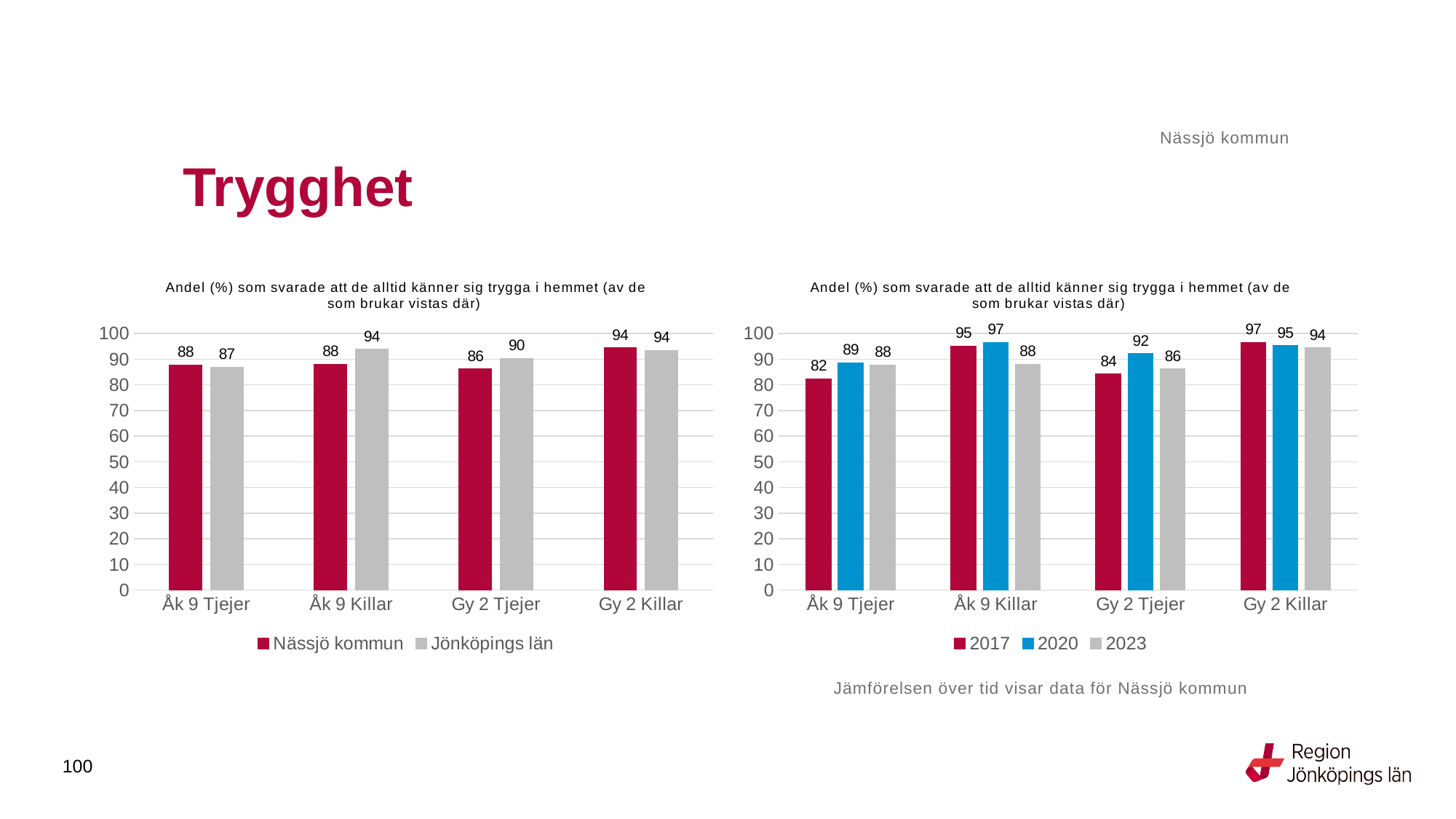
In the right chart, which category has the highest value for 2017? Gy 2 Killar In the right chart, what is the difference between the 2020 and 2017 values for Åk 9 Tjejer? 7 In the left chart, what is the value for Jönköpings län for Gy 2 Tjejer? 90 In the right chart, which is larger for Åk 9 Killar: the 2020 value or the 2023 value? 2020 In the left chart, which category has the lowest value for Nässjö kommun? Gy 2 Tjejer In the left chart, how many series does the legend list? 2 In the left chart, what is the difference between Jönköpings län and Nässjö kommun for Åk 9 Killar? 6 In the right chart, what is the value for 2020 for Gy 2 Tjejer? 92 In the left chart, what is the value for Nässjö kommun for Åk 9 Killar? 88 What kind of chart is the right chart? Bar chart In the right chart, how many categories are shown on the x axis? 4 In the right chart, what is the value for 2017 for Åk 9 Tjejer? 82